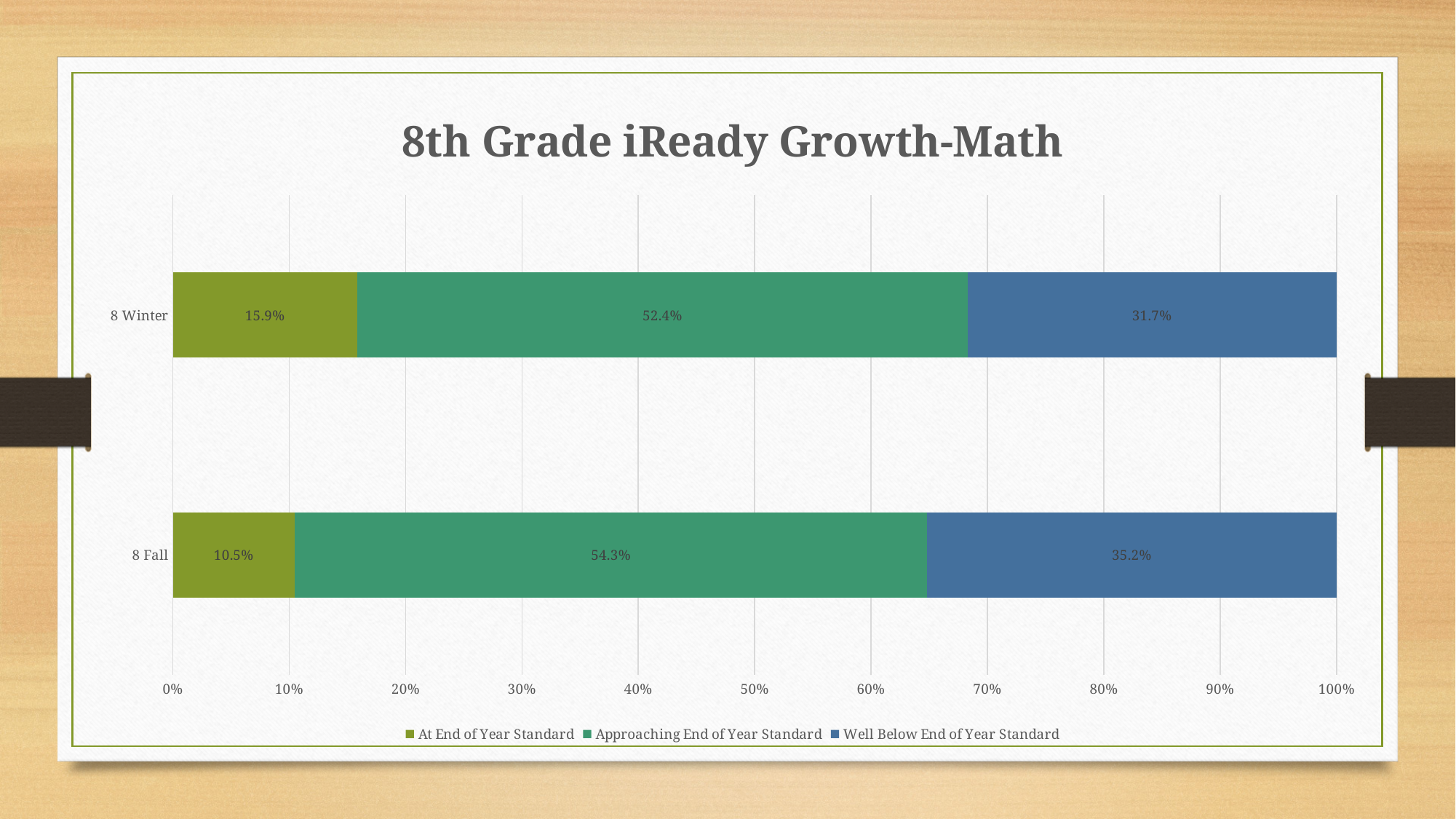
What is the value for At End of Year Standard in 8 Fall? 10.5% What is the value for At End of Year Standard in 8 Winter? 15.9% What type of chart is shown on the slide? Stacked bar chart What is the difference between the At End of Year Standard values for 8 Winter and 8 Fall? 5.4% What is the value for Approaching End of Year Standard in 8 Fall? 54.3% Which series has the lowest value in 8 Fall? At End of Year Standard What is the value for Well Below End of Year Standard in 8 Winter? 31.7% How many categories are shown on the chart? 2 How many series does the legend list? 3 Which category has the higher value for Well Below End of Year Standard, 8 Winter or 8 Fall? 8 Fall What is the difference between the Well Below End of Year Standard values for 8 Fall and 8 Winter? 3.5% Which series has the highest value in 8 Winter? Approaching End of Year Standard